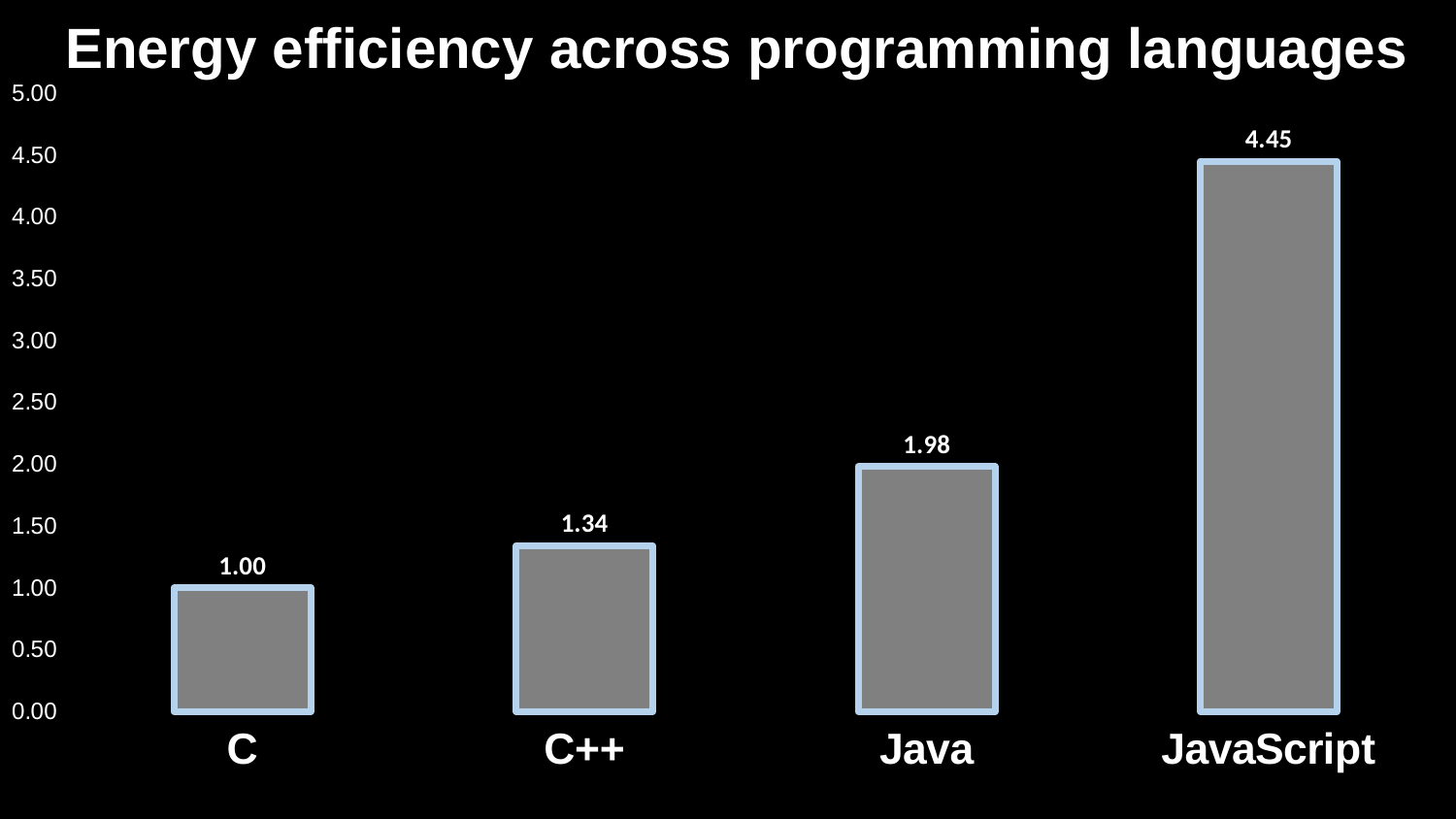
Which programming language has the lowest value? C How many programming languages are shown in the chart? 4 Which programming language has the highest value? JavaScript What kind of chart is shown on the slide? Bar chart What is the difference between the values for C++ and C? 0.34 Which has a larger value, Java or C++? Java Do the values rise or fall from left to right across the x axis? Rise What is the value for Java? 1.98 What is the difference between the values for JavaScript and Java? 2.47 What is the value for JavaScript? 4.45 What is the value for C? 1.00 What is the value for C++? 1.34